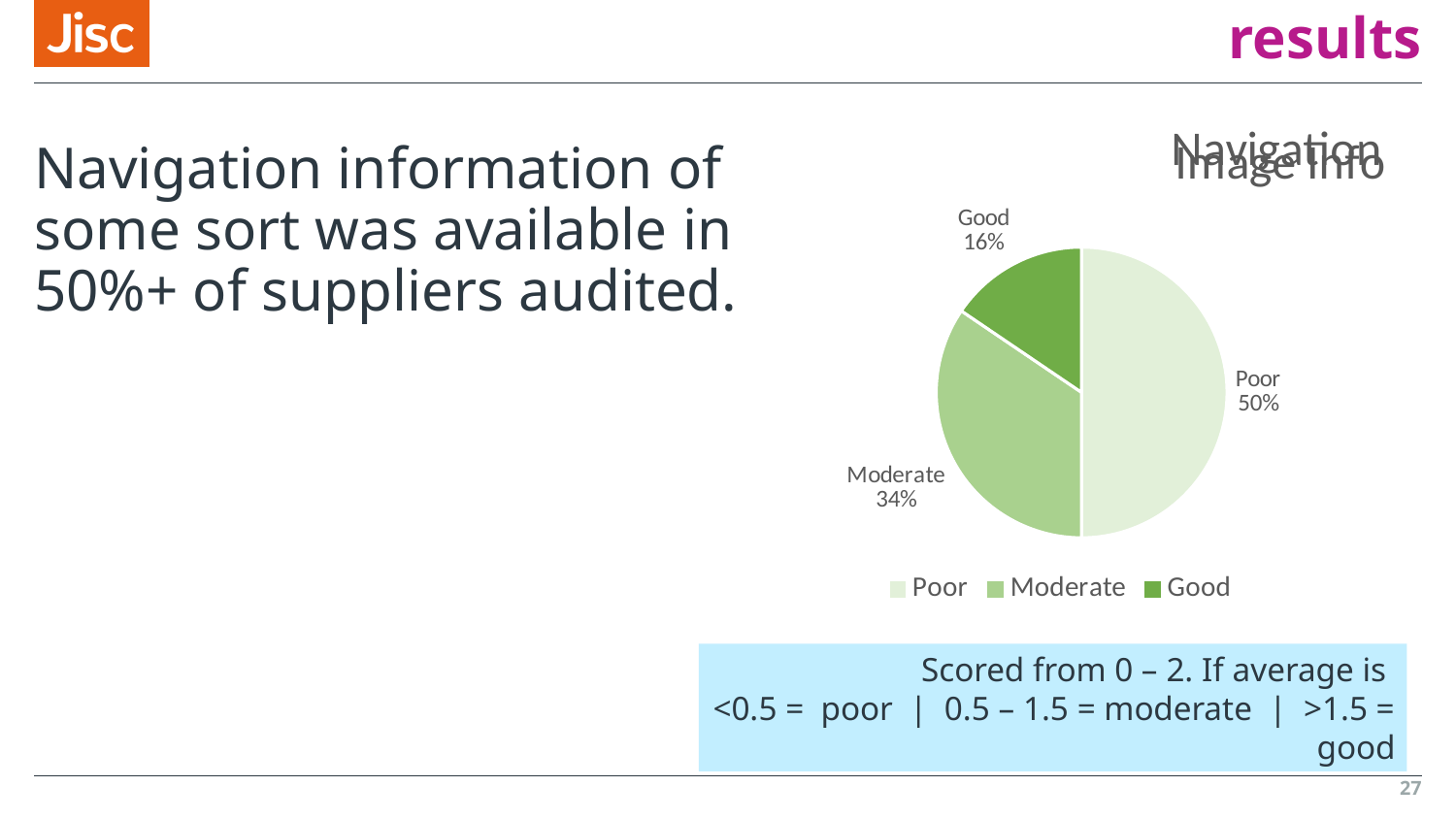
What is the difference in percentage points between the Moderate and Good slices? 18 What are the three categories listed in the legend, in order? Poor, Moderate, Good What percentage of the pie chart is labelled Good? 16% What percentage of the pie chart is labelled Moderate? 34% How many entries does the legend list? 3 Which category has the largest slice of the pie chart? Poor What type of chart is shown on the slide? Pie chart What percentage of the pie chart is labelled Poor? 50% How many slices does the pie chart have? 3 What is the difference in percentage points between the Poor and Moderate slices? 16 Which category has the smallest slice of the pie chart? Good Which slice is larger, Moderate or Good? Moderate